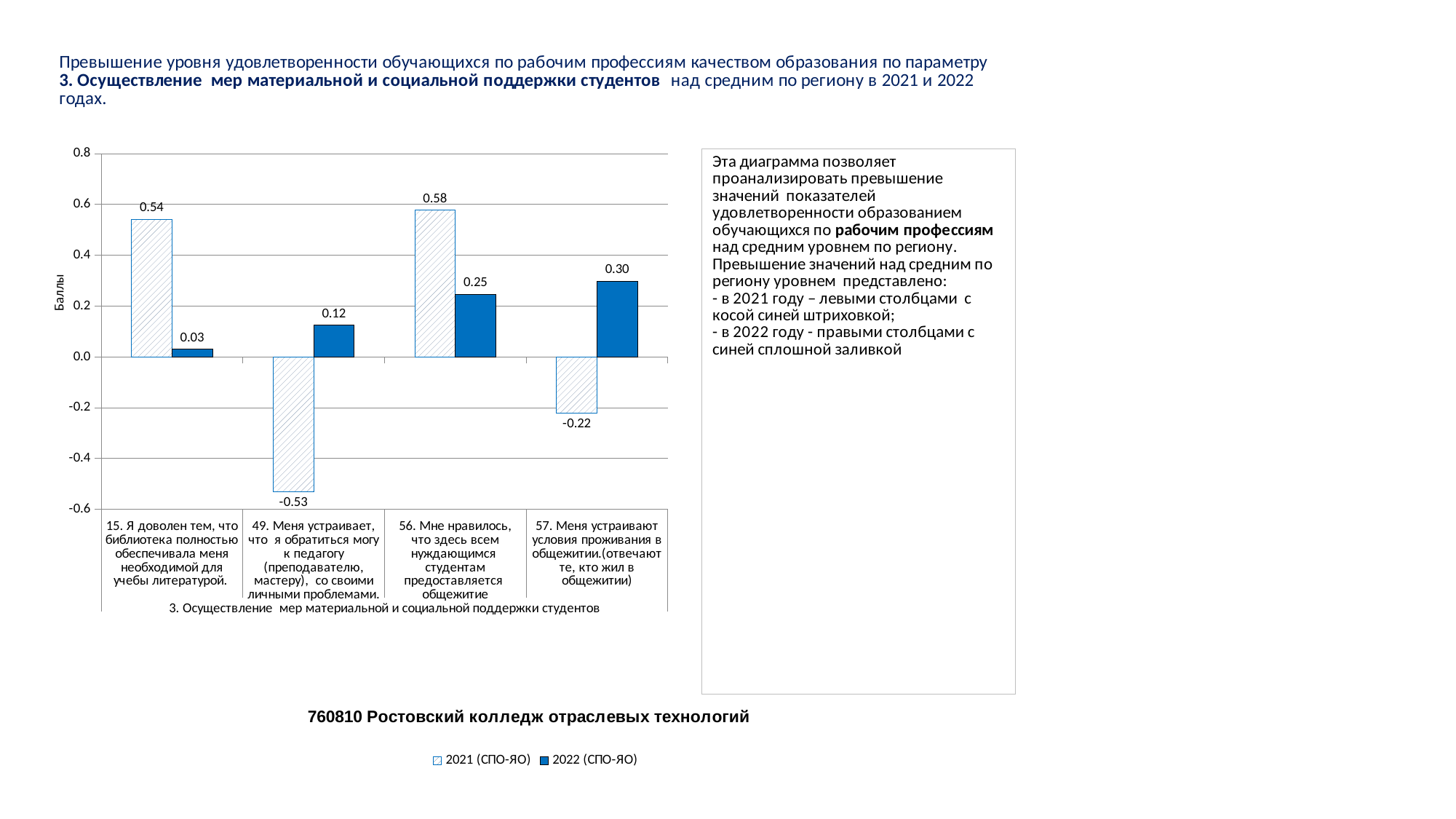
What kind of chart is shown on the slide? Bar chart For question 57, which is larger: the 2021 (СПО-ЯО) value or the 2022 (СПО-ЯО) value? 2022 (СПО-ЯО) Which category has the lowest 2022 (СПО-ЯО) value? 15. Я доволен тем, что библиотека полностью обеспечивала меня необходимой для учебы литературой. What is the 2022 (СПО-ЯО) value for question 49 (Меня устраивает, что я обратиться могу к педагогу)? 0.12 How many series does the legend list? 2 Which category has the highest 2021 (СПО-ЯО) value? 56. Мне нравилось, что здесь всем нуждающимся студентам предоставляется общежитие What is the 2021 (СПО-ЯО) value for question 57 (Меня устраивают условия проживания в общежитии)? -0.22 How many categories are shown on the x axis of the chart? 4 Which category has the lowest 2021 (СПО-ЯО) value? 49. Меня устраивает, что я обратиться могу к педагогу (преподавателю, мастеру), со своими личными проблемами. What is the 2021 (СПО-ЯО) value for question 15 (Я доволен тем, что библиотека полностью обеспечивала меня необходимой для учебы литературой)? 0.54 What is the difference between the 2021 and 2022 values for question 15? 0.51 What is the 2022 (СПО-ЯО) value for question 56 (Мне нравилось, что здесь всем нуждающимся студентам предоставляется общежитие)? 0.25